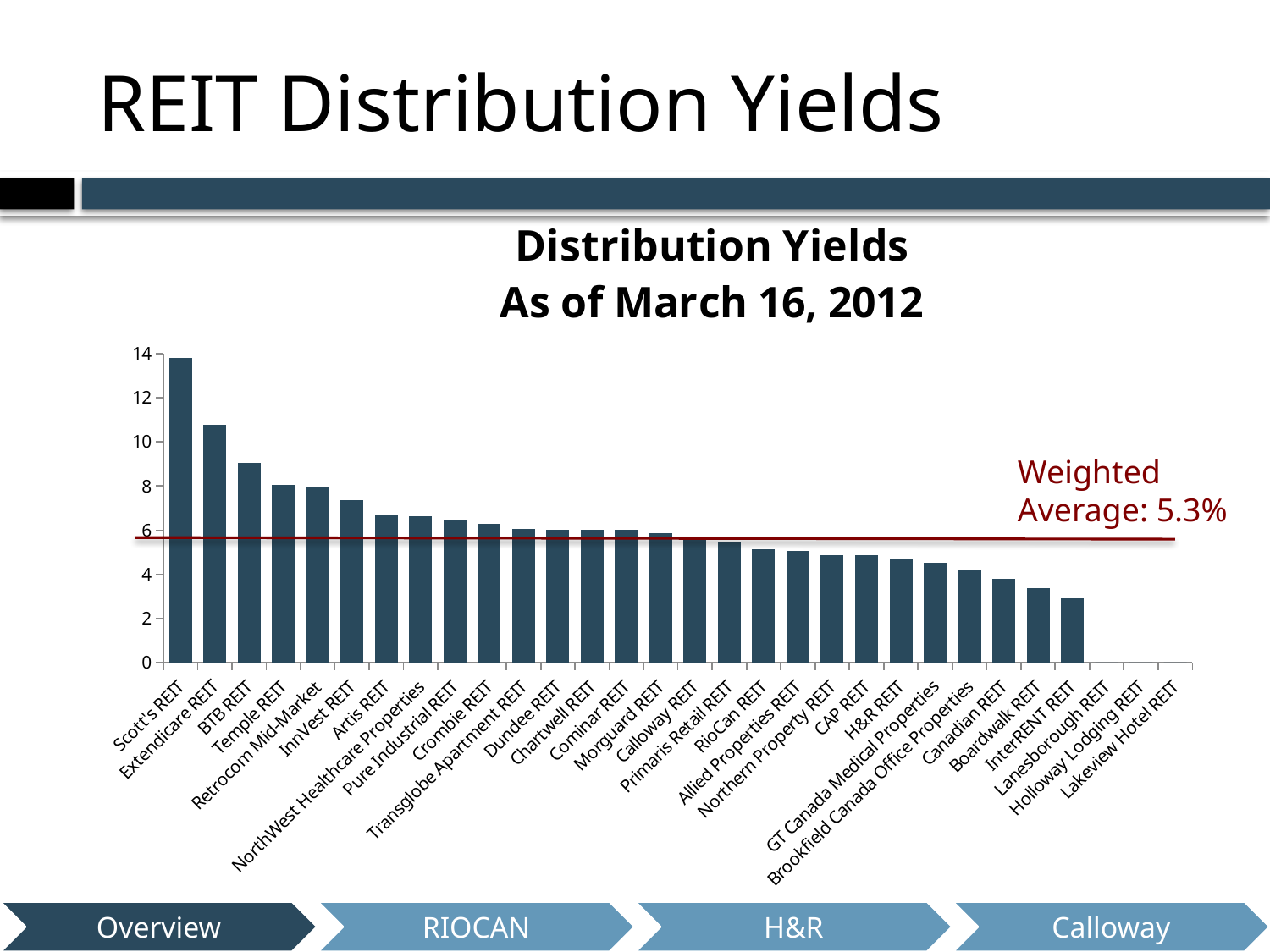
Which REIT has the highest distribution yield in the chart? Scott's REIT Which REIT with a visible bar has the lowest distribution yield? InterRENT REIT What kind of chart is shown on the slide? Bar chart Is the distribution yield for BTB REIT greater or less than 8? greater Which has a higher distribution yield, Artis REIT or Canadian REIT? Artis REIT Do the distribution yields rise or fall moving from left to right along the x axis? Fall Is the distribution yield for RioCan REIT greater or less than 6? less Is the distribution yield for Scott's REIT greater or less than 12? greater What weighted average distribution yield is marked by the horizontal line on the chart? 5.3%